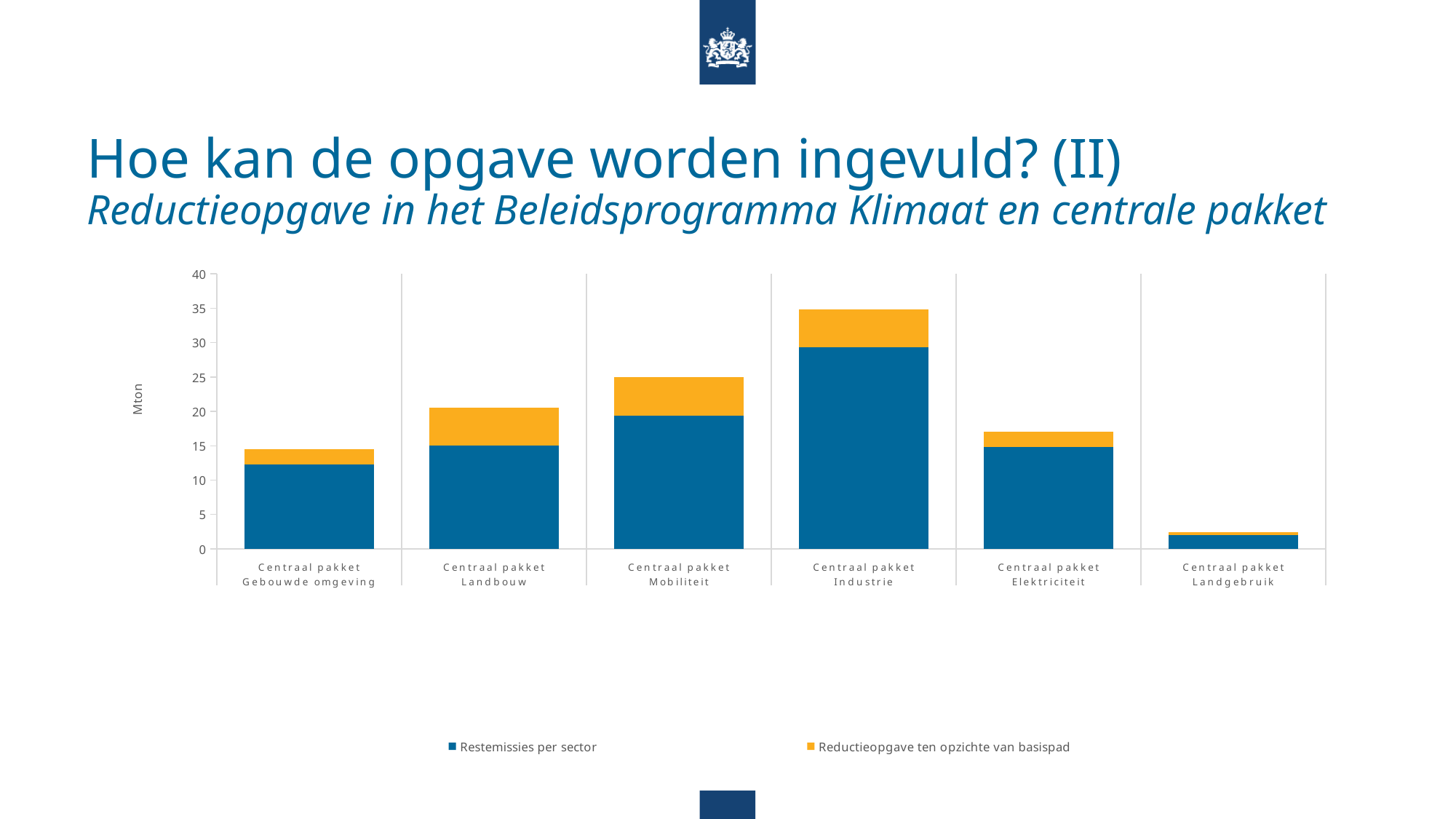
What kind of chart is shown on the slide? Stacked bar chart Is the total bar for Centraal pakket Landgebruik greater or less than 5? less Which category has the lowest total bar in the chart? Centraal pakket Landgebruik Is the Restemissies per sector value for Centraal pakket Industrie greater or less than 25? greater How many series does the chart's legend list? 2 Which has the larger total bar: Centraal pakket Mobiliteit or Centraal pakket Landbouw? Centraal pakket Mobiliteit Is the total bar for Centraal pakket Elektriciteit greater or less than 15? greater How many categories are shown on the x axis of the chart? 6 Which category has the highest total bar in the chart? Centraal pakket Industrie Which series is shown in orange in the chart? Reductieopgave ten opzichte van basispad What is the label on the y axis of the chart? Mton